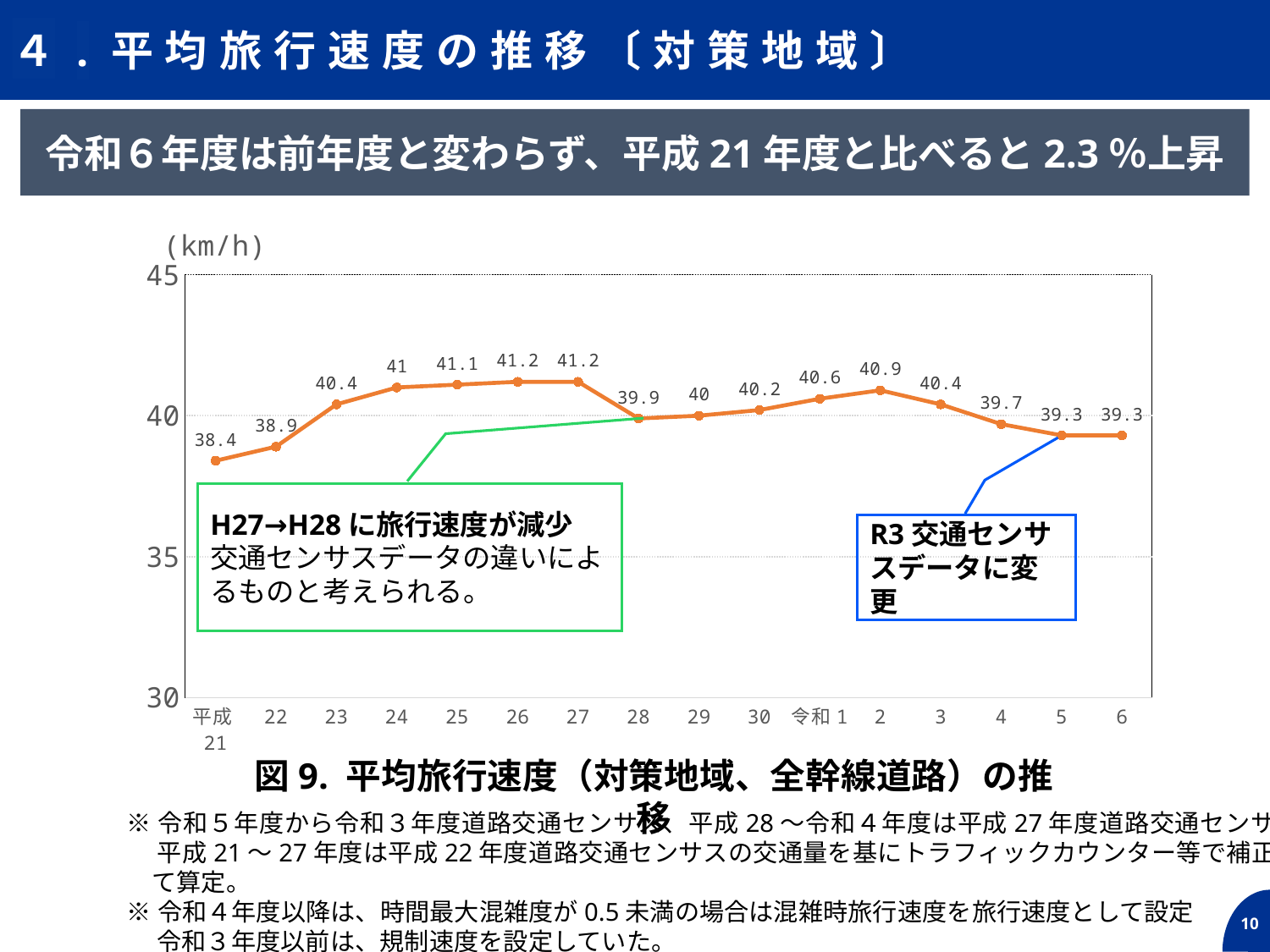
What kind of chart is shown on the slide? line chart What is the value plotted for 平成28? 39.9 How many data points are plotted on the line? 16 Is the value for 平成22 greater or less than 40? less What unit is shown on the vertical axis? km/h What is the highest value shown on the line? 41.2 What is the value plotted for 令和2? 40.9 What is the value plotted for 令和6? 39.3 What is the difference between the values for 平成27 and 平成28? 1.3 Which year has the lowest average travel speed? 平成21 What is the average travel speed for 平成21? 38.4 Which is larger, the value for 令和2 or the value for 令和4? 令和2